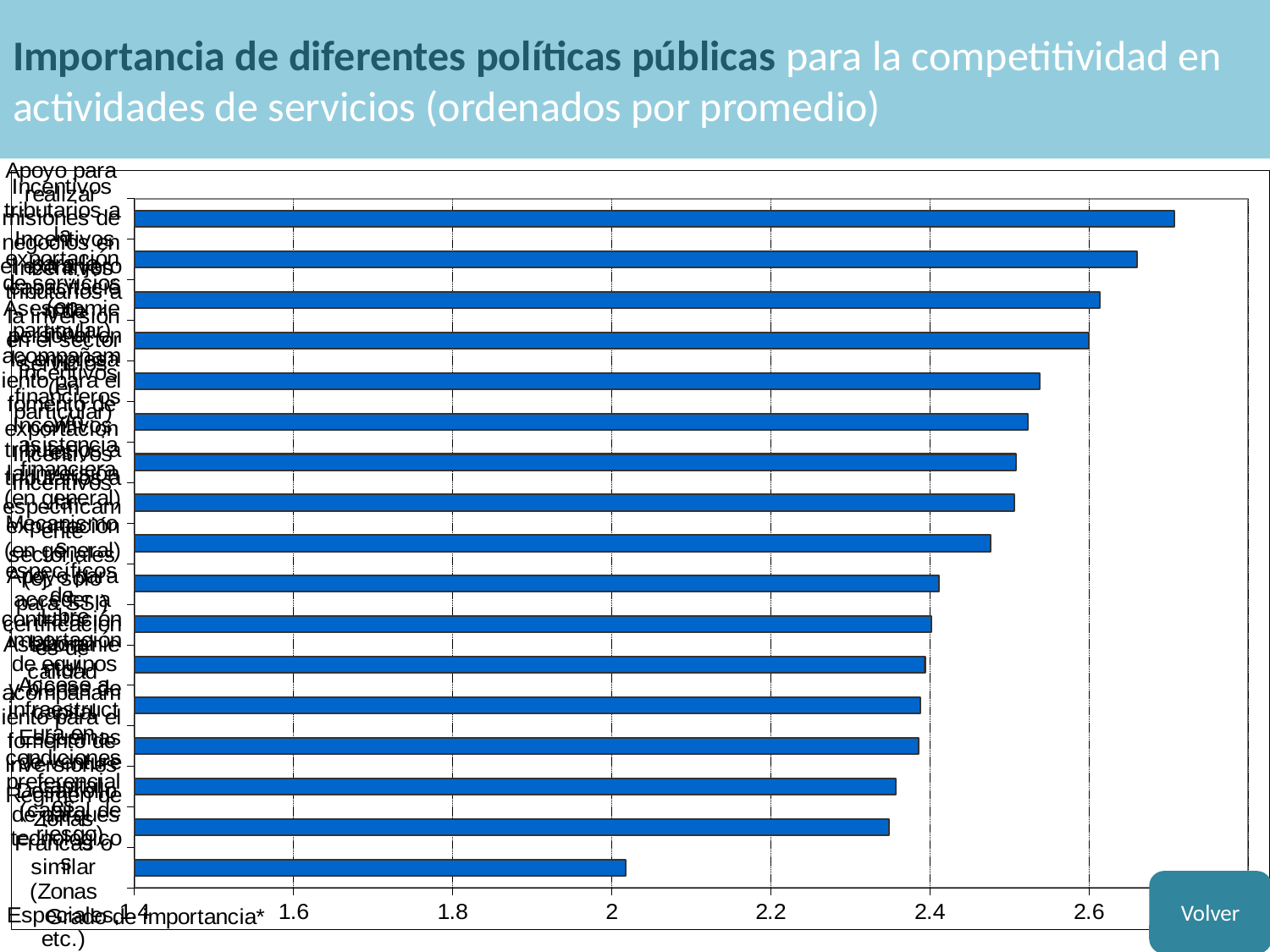
Is the value of the topmost bar greater or less than 2.6? greater How many bars does the chart contain? 17 Where is the shortest bar located in the chart, at the top or at the bottom? at the bottom What kind of chart is shown on the slide? bar chart Is the value of the second bar from the top greater or less than 2.6? greater Is the value of the fifth bar from the top greater or less than 2.4? greater Which bar has the larger value, the topmost bar or the bottom bar? the topmost bar Do the bar values increase or decrease going from the top of the chart to the bottom? decrease What is the title of the horizontal axis? Grado de importancia* Where is the longest bar located in the chart, at the top or at the bottom? at the top